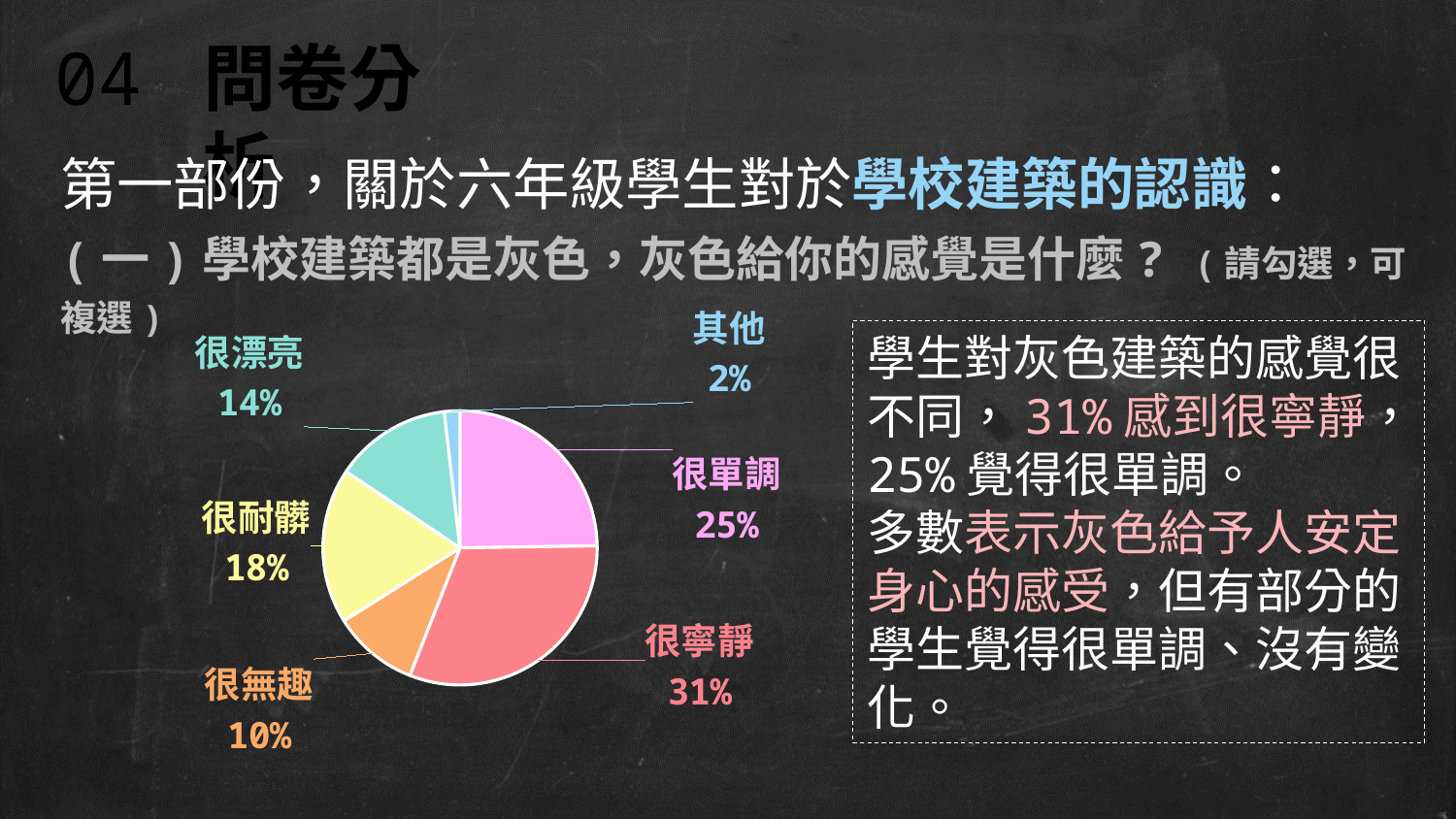
Which category has the smallest share of the pie? 其他 What percentage of students chose 很耐髒? 18% What percentage is shown for 其他? 2% How many slices does the pie chart have? 6 What kind of chart is shown on the slide? pie chart What percentage of students chose 很單調? 25% What percentage of students chose 很無趣? 10% What is the difference in percentage points between 很寧靜 and 很單調? 6 Which is larger, the share for 很漂亮 or the share for 很耐髒? 很耐髒 Which category has the largest share of the pie? 很寧靜 What colour is the 很寧靜 slice of the pie? pink What percentage of students chose 很寧靜? 31%